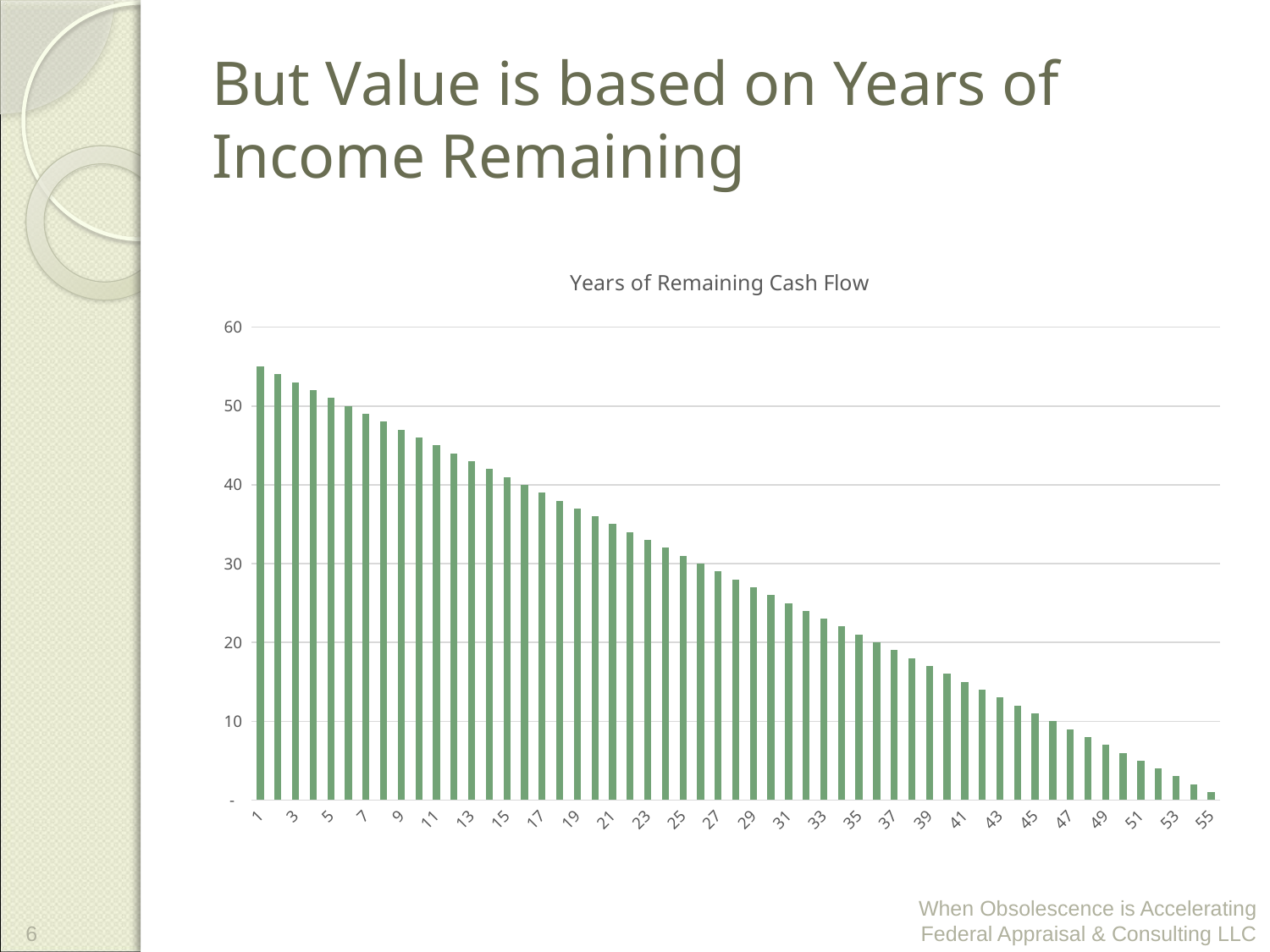
Do the bar values rise or fall as you move from left to right along the x axis? fall What kind of chart is shown on the slide? bar chart Which has the larger value, category 11 or category 41? 11 Is the value for category 21 greater or less than 30? greater How many bars are plotted in the chart? 55 Is the value for category 41 greater or less than 20? less Is the value for category 1 greater or less than 50? greater What colour are the bars in the chart? green What is the title of the chart? Years of Remaining Cash Flow Which category has the tallest bar? 1 Which category has the shortest bar? 55